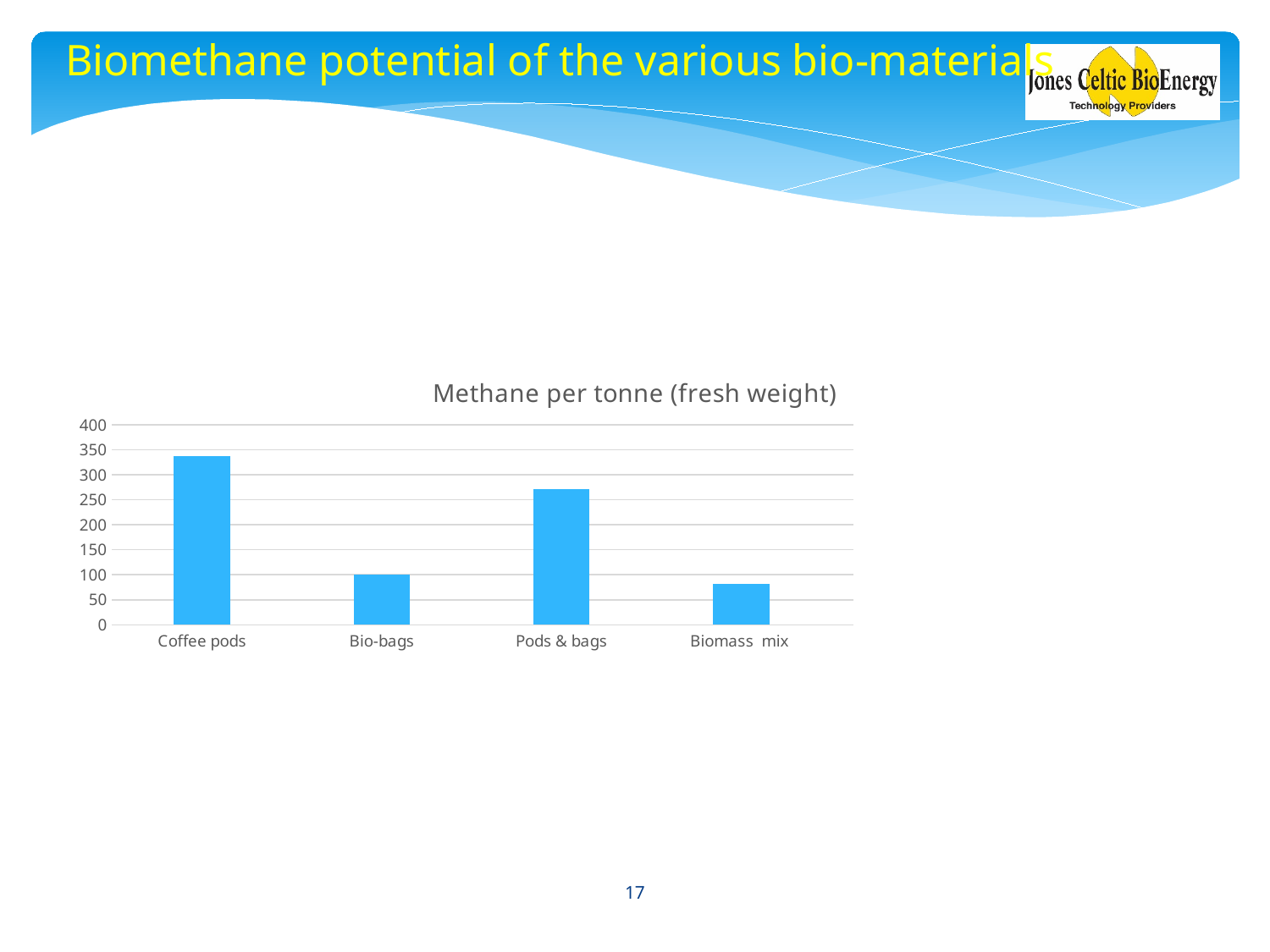
How many categories are shown on the x axis of the chart? 4 Is the value for Biomass mix greater or less than 100? less What is the maximum value shown on the y axis of the chart? 400 Which is larger, the value for Coffee pods or the value for Pods & bags? Coffee pods Which category has the highest methane per tonne? Coffee pods What kind of chart is shown on the slide? bar chart What is the title of the chart? Methane per tonne (fresh weight) Which is larger, the value for Bio-bags or the value for Biomass mix? Bio-bags Is the value for Coffee pods greater or less than 300? greater Is the value for Bio-bags greater or less than 150? less Which category has the lowest methane per tonne? Biomass mix